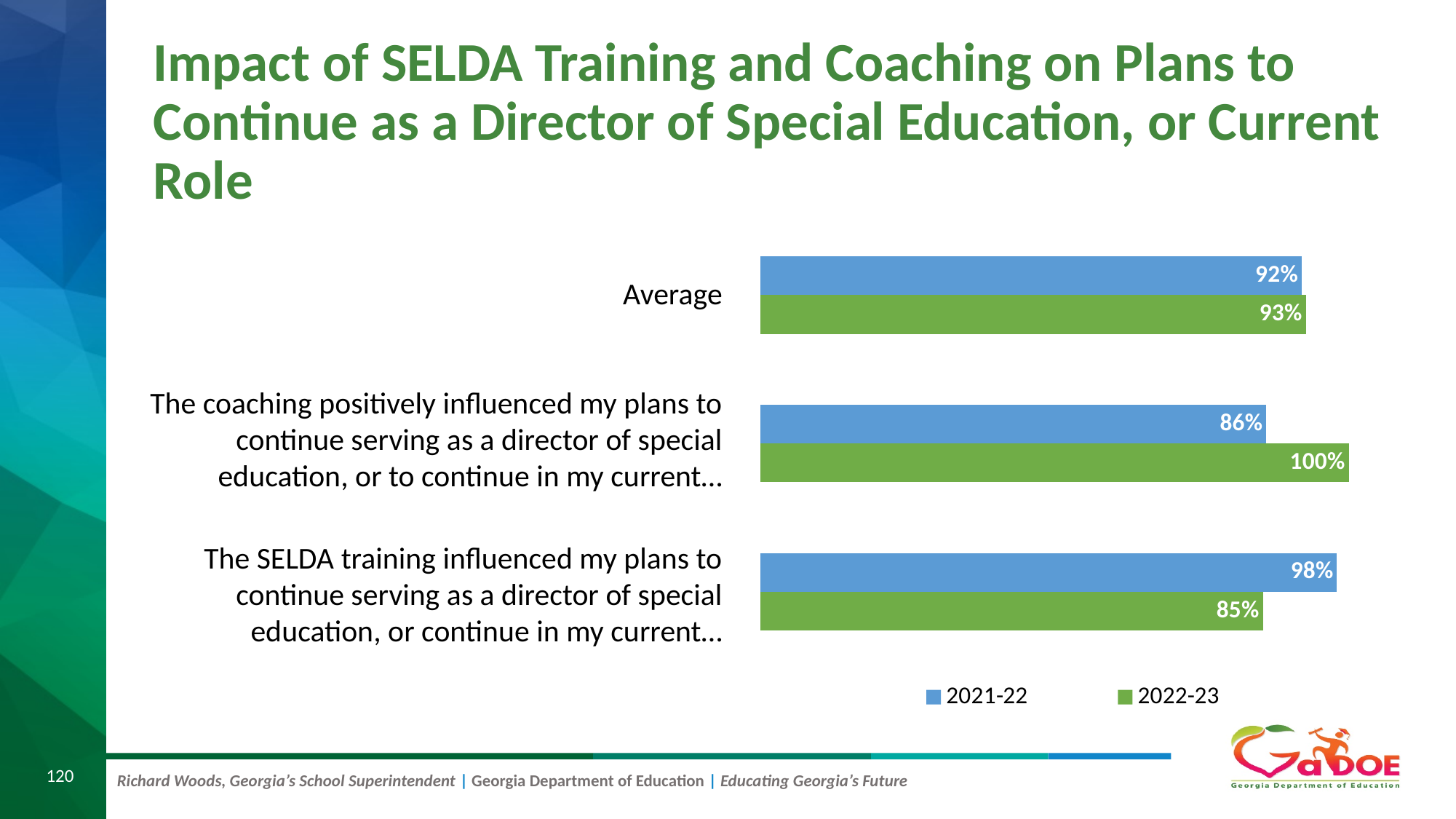
For the SELDA training statement, which year has the larger value, 2021-22 or 2022-23? 2021-22 What is the 2021-22 value for "The SELDA training influenced my plans to continue serving as a director of special education, or continue in my current…"? 98% What is the 2022-23 value for "The SELDA training influenced my plans to continue serving as a director of special education, or continue in my current…"? 85% Which category has the lowest 2021-22 value? The coaching positively influenced my plans to continue serving as a director of special education, or to continue in my current… What is the 2021-22 value for Average? 92% How many categories are shown in the chart? 3 How many series does the legend list? 2 What is the 2022-23 value for "The coaching positively influenced my plans to continue serving as a director of special education, or to continue in my current…"? 100% What is the difference between the 2022-23 and 2021-22 values for the coaching statement? 14% What kind of chart is shown on the slide? Bar chart Which category has the highest 2022-23 value? The coaching positively influenced my plans to continue serving as a director of special education, or to continue in my current… What is the 2022-23 value for Average? 93%